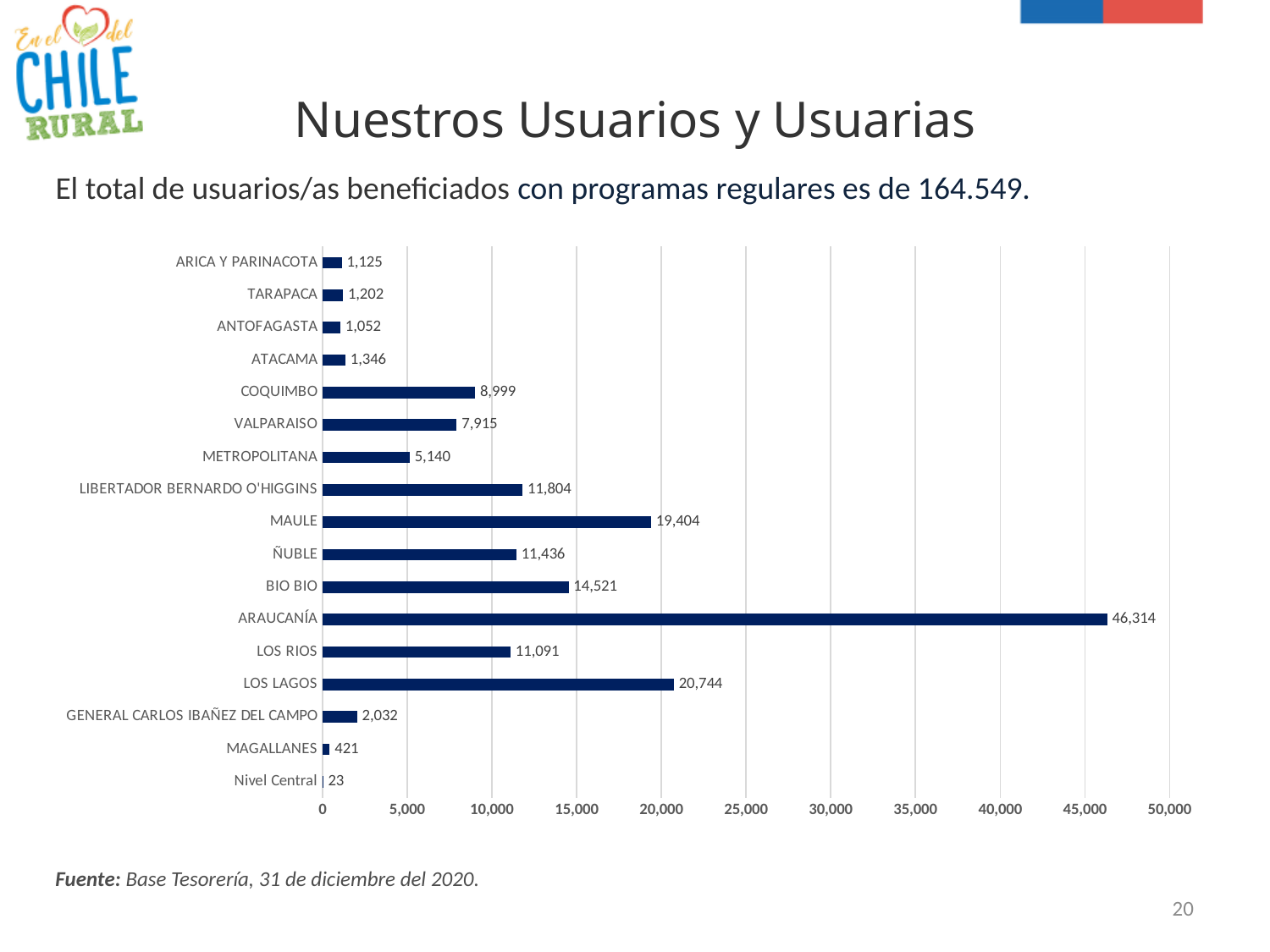
Which is larger, the value for COQUIMBO or the value for VALPARAISO? COQUIMBO Which category has the lowest value? Nivel Central What is the value for Nivel Central? 23 What kind of chart is shown on the slide? bar chart Which category has the highest value? ARAUCANÍA Is the value for LOS LAGOS greater or less than 20,000? greater What is the value for LOS LAGOS? 20,744 What is the value for ARAUCANÍA? 46,314 What is the value for METROPOLITANA? 5,140 How many categories are shown in the chart? 17 What is the difference between the values for MAULE and BIO BIO? 4,883 What is the difference between the values for ARAUCANÍA and LOS LAGOS? 25,570